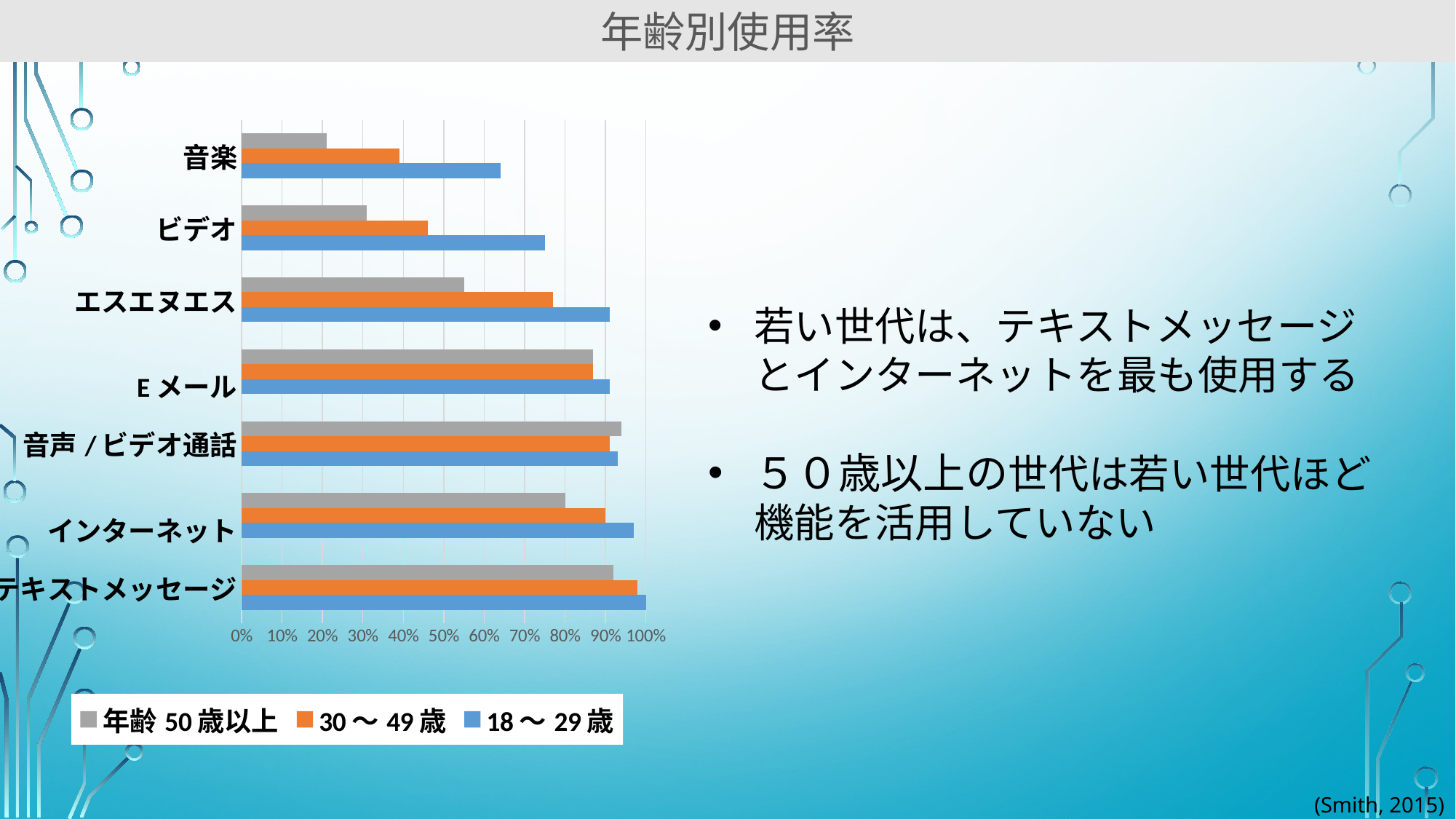
Is the value for 音楽 in the 年齢 50歳以上 series greater or less than 30%? less Is the value for 音楽 in the 18～29歳 series greater or less than 50%? greater Is the value for ビデオ in the 18～29歳 series greater or less than 70%? greater Which category has the lowest value in the 18～29歳 series? 音楽 What is the title of the chart? 年齢別使用率 For ビデオ, which series has the larger value: 年齢 50歳以上 or 18～29歳? 18～29歳 How many series does the legend list? 3 What kind of chart is shown on the slide? bar chart Which category has the lowest value in the 年齢 50歳以上 series? 音楽 How many categories are plotted on the chart? 7 Which colour represents the 18～29歳 series? blue